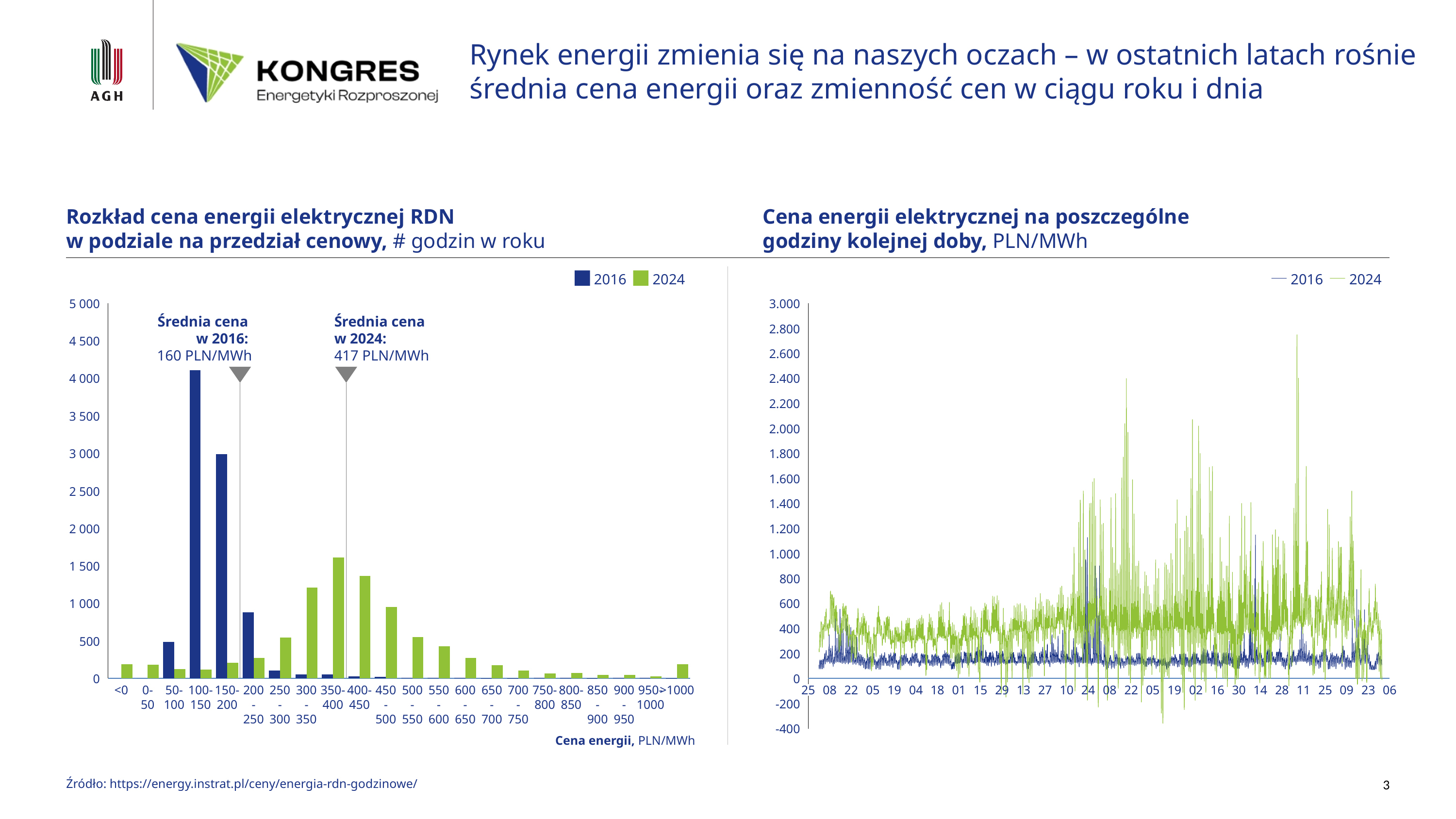
On the left chart, how many series does the legend list? 2 On the left chart, what is the difference between the annotated average price in 2024 and in 2016? 257 PLN/MWh On the left chart, what is the average energy price in 2024 given in the annotation? 417 PLN/MWh On the left chart, which price range has the highest number of hours for 2024? 350-400 What kind of chart is the left chart, 'Rozkład cena energii elektrycznej RDN w podziale na przedział cenowy'? bar chart What kind of chart is the right chart, 'Cena energii elektrycznej na poszczególne godziny kolejnej doby'? line chart On the left chart, what is the average energy price in 2016 given in the annotation? 160 PLN/MWh On the left chart, is the 2016 value for the 100-150 price range greater or less than 3 500? greater On the left chart, is the 2024 value for the 400-450 price range greater or less than 1 500? less On the left chart, how many price range categories are shown on the x axis? 22 On the left chart, which is larger: the 2016 bar for 100-150 or the 2024 bar for 350-400? the 2016 bar for 100-150 On the left chart, which price range has the highest number of hours for 2016? 100-150